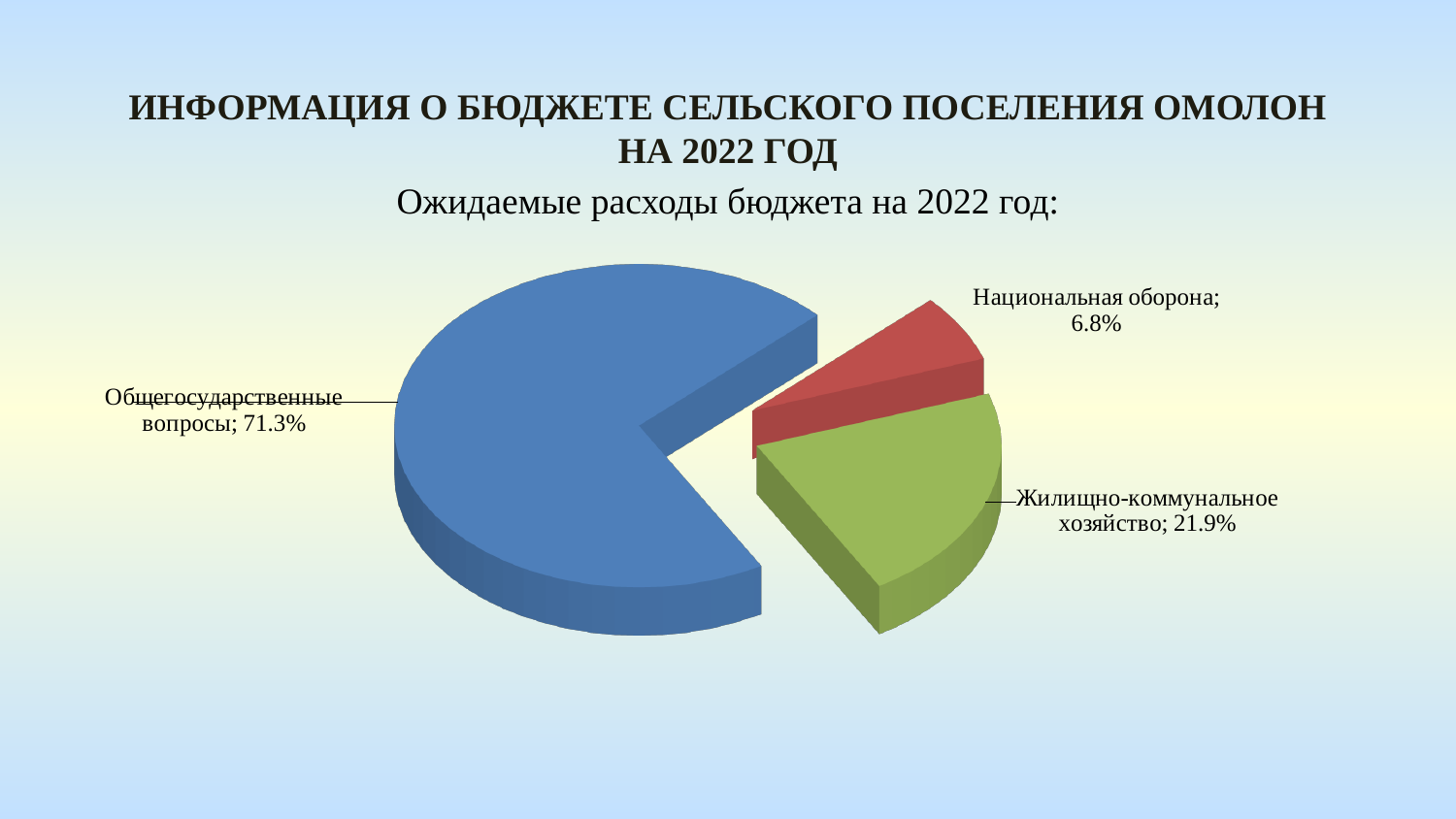
What is the difference between the shares of Общегосударственные вопросы and Жилищно-коммунальное хозяйство? 49.4% How many categories are shown in the pie chart? 3 Which category has the largest slice of the pie? Общегосударственные вопросы What is the difference between the shares of Жилищно-коммунальное хозяйство and Национальная оборона? 15.1% What is the subtitle above the chart? Ожидаемые расходы бюджета на 2022 год: What share of the pie does Национальная оборона have? 6.8% What share of the pie does Общегосударственные вопросы have? 71.3% What colour is the slice for Общегосударственные вопросы? Blue What share of the pie does Жилищно-коммунальное хозяйство have? 21.9% What kind of chart is shown on the slide? Pie chart Which is larger: the share of Жилищно-коммунальное хозяйство or the share of Национальная оборона? Жилищно-коммунальное хозяйство Which category has the smallest slice of the pie? Национальная оборона